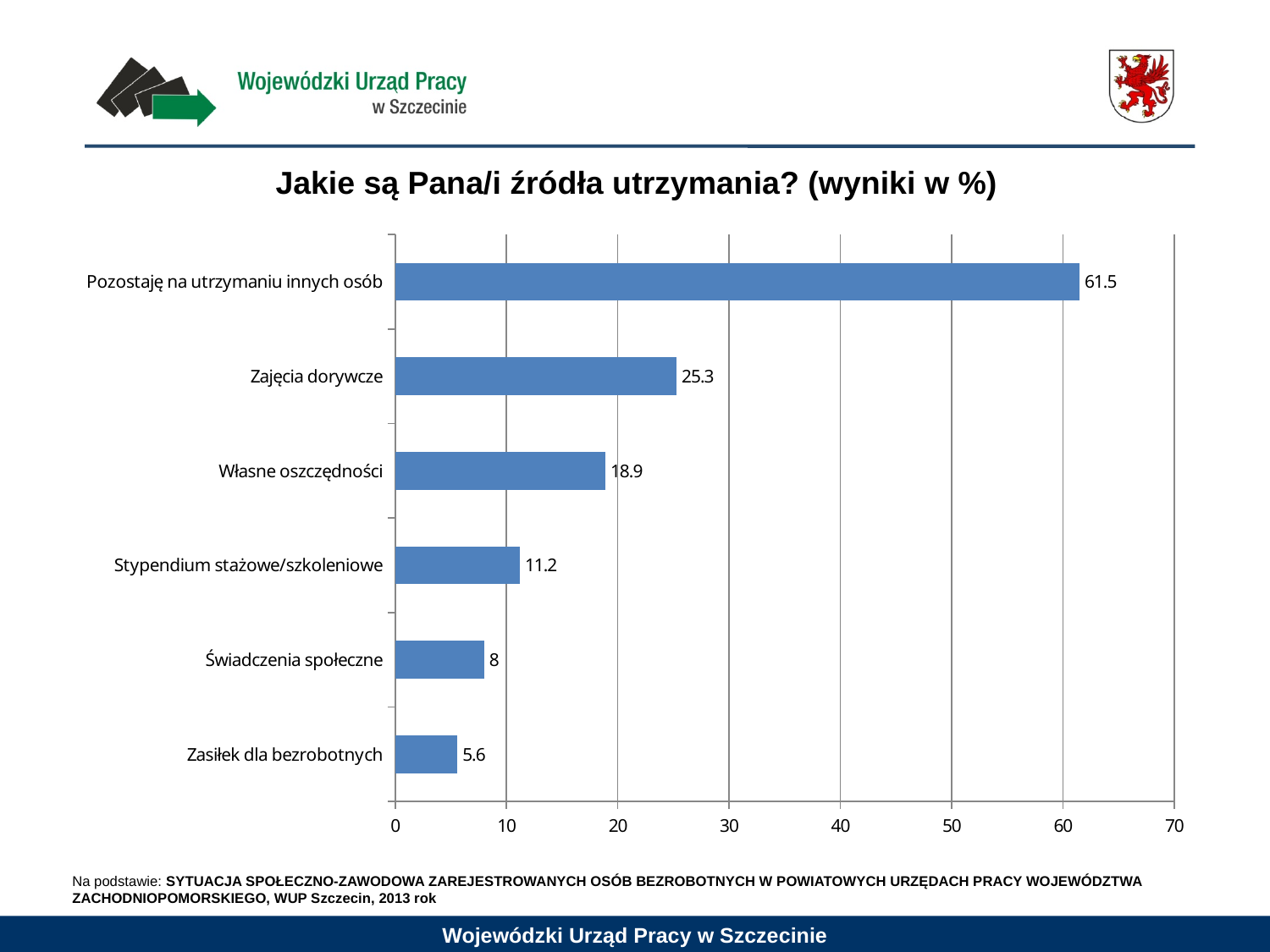
What is the value for "Zajęcia dorywcze"? 25.3 Which category has the highest value? Pozostaję na utrzymaniu innych osób Which is larger, the value for "Świadczenia społeczne" or the value for "Zasiłek dla bezrobotnych"? Świadczenia społeczne What is the value for "Stypendium stażowe/szkoleniowe"? 11.2 How many categories are shown in the chart? 6 Is the value for "Własne oszczędności" greater or less than 20? less What is the title of the chart? Jakie są Pana/i źródła utrzymania? (wyniki w %) What is the value for "Pozostaję na utrzymaniu innych osób"? 61.5 What is the difference between the values for "Zajęcia dorywcze" and "Własne oszczędności"? 6.4 What kind of chart is shown on the slide? bar chart Which category has the lowest value? Zasiłek dla bezrobotnych What is the value for "Zasiłek dla bezrobotnych"? 5.6